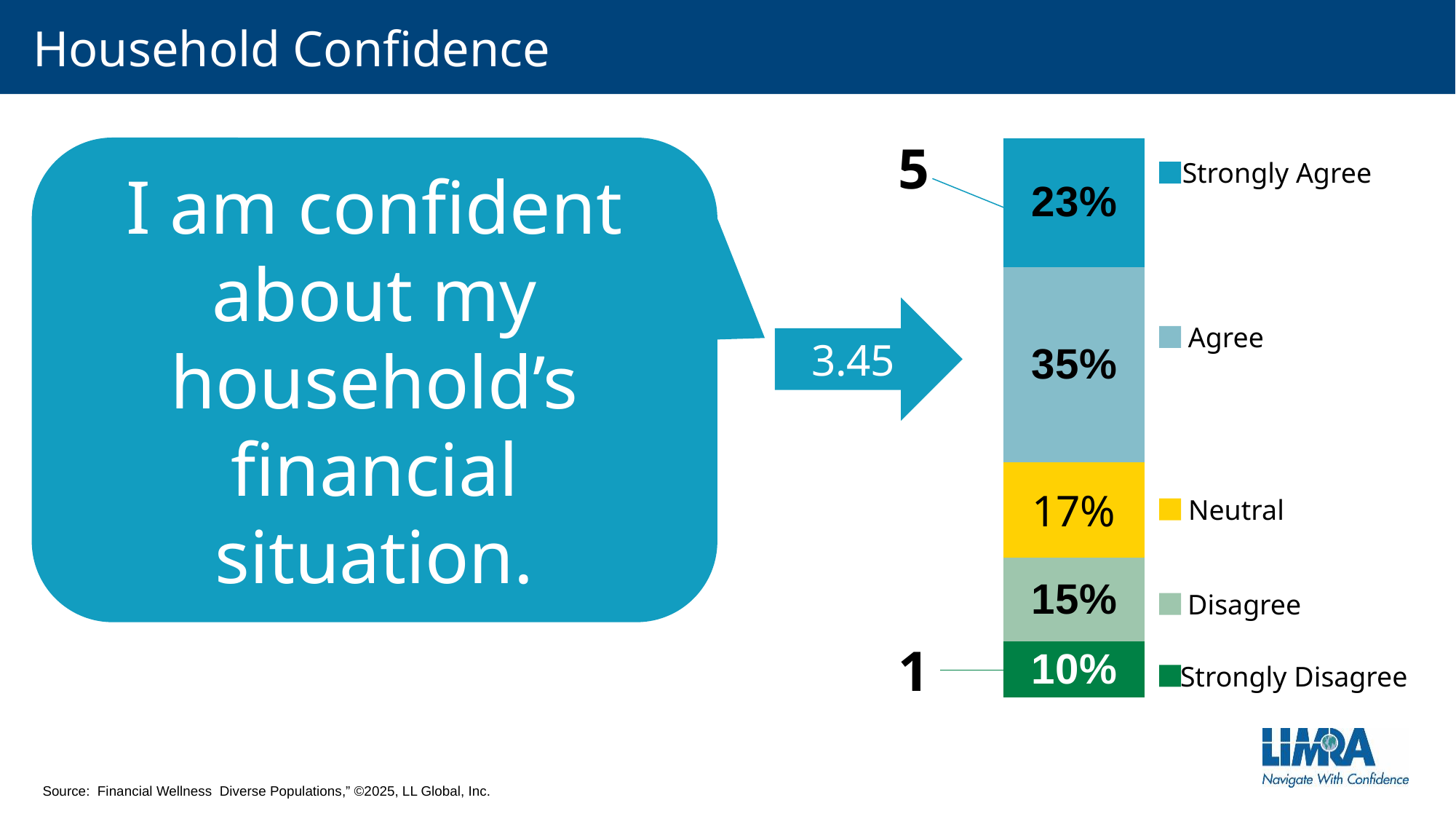
What is the difference between the Agree and Strongly Agree percentages? 12% What percentage of respondents Agree with the statement? 35% How many response categories does the legend list? 5 What percentage of respondents Strongly Agree with the statement? 23% Which is larger, the Neutral share or the Disagree share? Neutral Which response category has the smallest share? Strongly Disagree Which response category has the largest share? Agree What percentage of respondents are Neutral? 17% What percentage of respondents Strongly Disagree? 10% What percentage of respondents Disagree? 15% What is the combined percentage of Strongly Agree and Agree responses? 58% What is the average score shown in the arrow next to the chart? 3.45